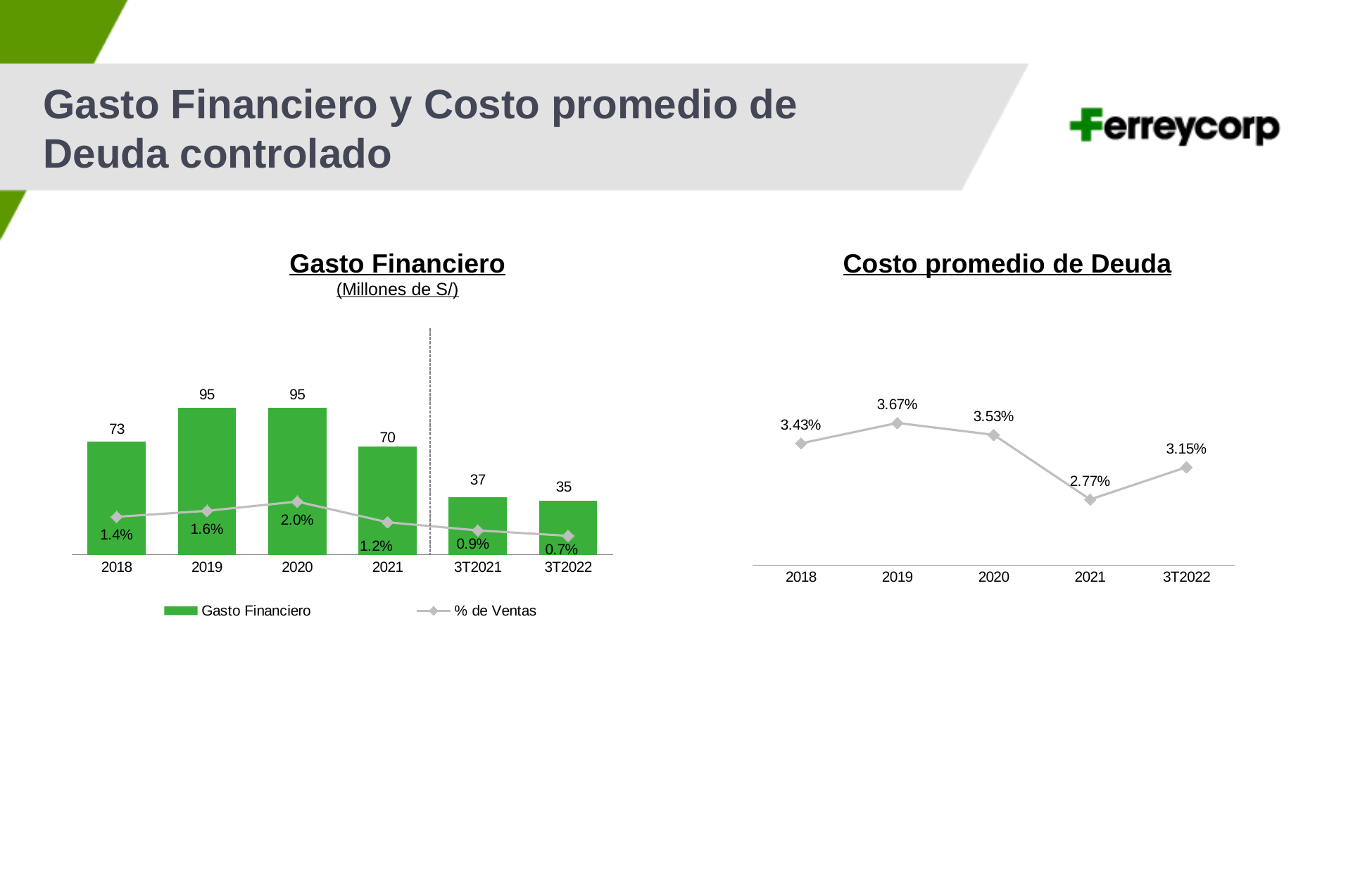
In the Costo promedio de Deuda chart, which year has the highest value? 2019 In the Gasto Financiero chart, which category has the lowest Gasto Financiero value? 3T2022 In the Costo promedio de Deuda chart, which is larger, the value for 2018 or the value for 3T2022? 2018 In the Gasto Financiero chart, what is the difference between the Gasto Financiero values for 2020 and 2021? 25 What kind of chart is the Costo promedio de Deuda chart? Line chart In the Gasto Financiero chart, what is the % de Ventas value for 2020? 2.0% In the Gasto Financiero chart, what is the difference between the Gasto Financiero values for 3T2021 and 3T2022? 2 In the Costo promedio de Deuda chart, what is the value for 2021? 2.77% In the Gasto Financiero chart, how many categories are shown on the x axis? 6 In the Gasto Financiero chart, what is the Gasto Financiero value for 3T2022? 35 In the Gasto Financiero chart, what is the Gasto Financiero value for 2021? 70 In the Gasto Financiero chart, how many series does the legend list? 2